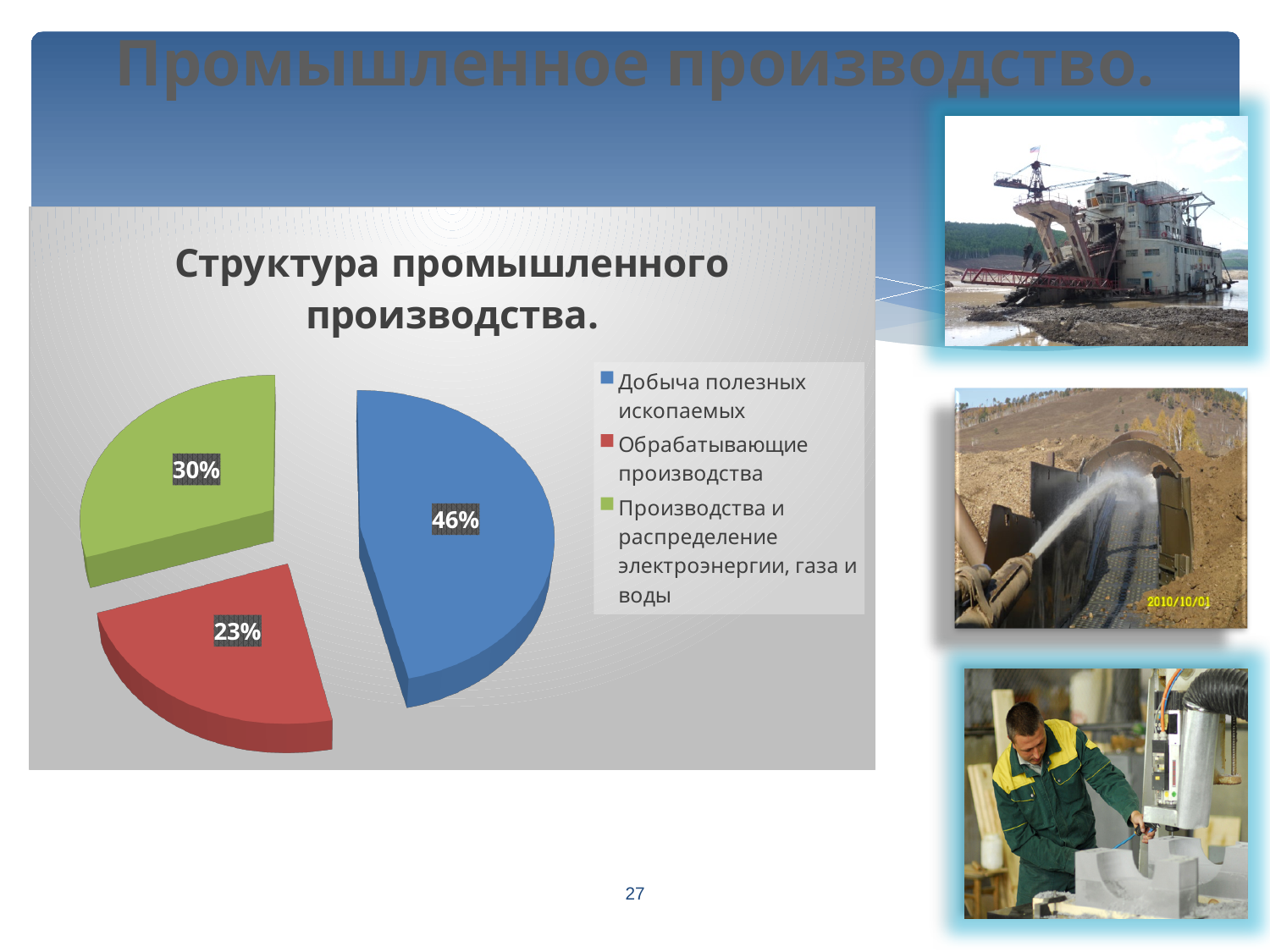
What share does Добыча полезных ископаемых have in the pie chart? 46% Which category has the smallest share of the pie? Обрабатывающие производства Which category has the largest share of the pie? Добыча полезных ископаемых What share does Производства и распределение электроэнергии, газа и воды have in the pie chart? 30% What is the difference in percentage points between Производства и распределение электроэнергии, газа и воды and Обрабатывающие производства? 7 Which is larger: the share for Обрабатывающие производства or the share for Производства и распределение электроэнергии, газа и воды? Производства и распределение электроэнергии, газа и воды What type of chart is shown on the slide? Pie chart What is the title of the chart? Структура промышленного производства. What colour is the slice for Добыча полезных ископаемых? Blue What is the difference in percentage points between Добыча полезных ископаемых and Обрабатывающие производства? 23 What share does Обрабатывающие производства have in the pie chart? 23% How many categories does the pie chart show? 3